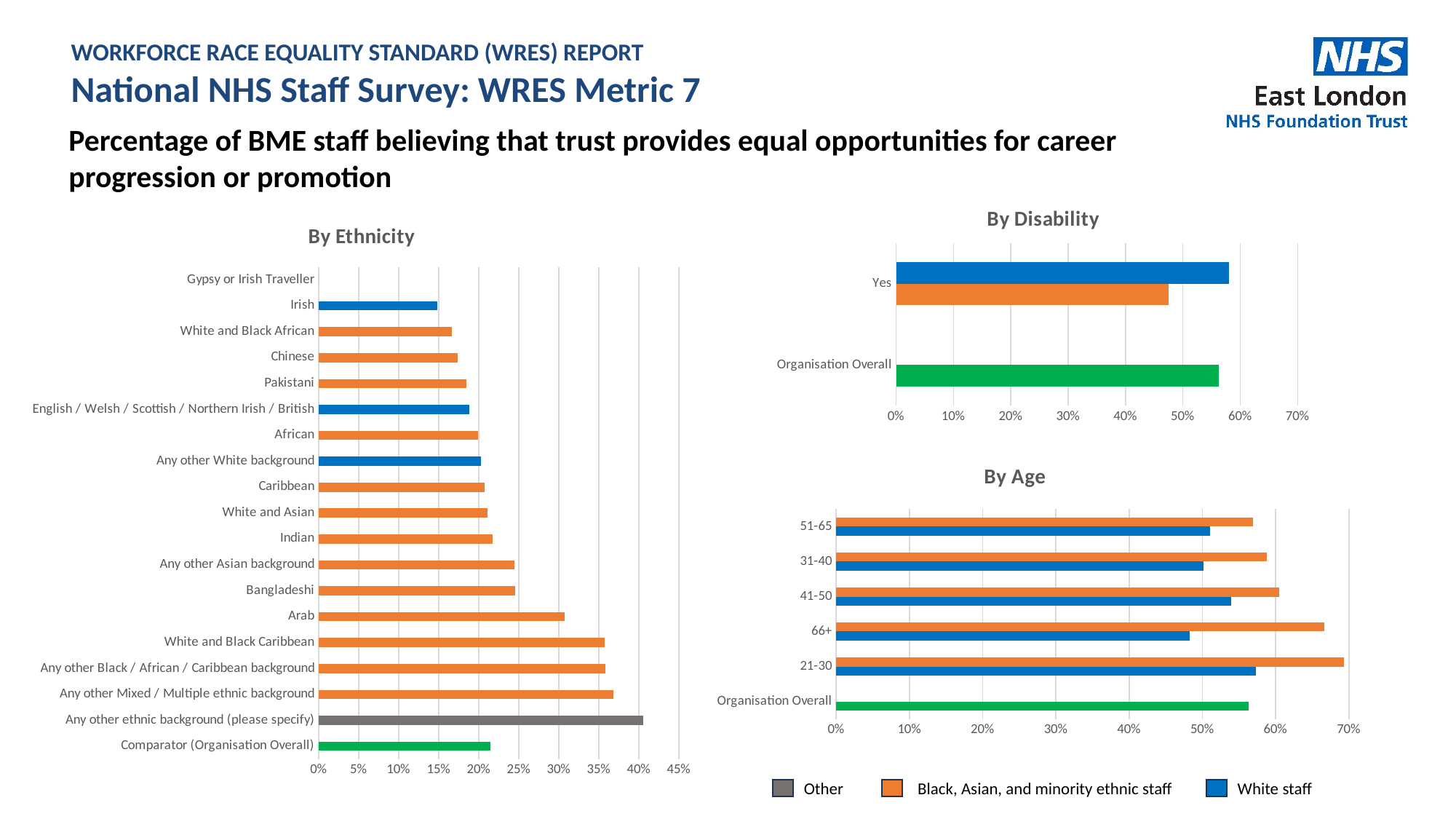
In the 'By Disability' chart, is the value for Black, Asian, and minority ethnic staff who answered Yes greater or less than 50%? less In the 'By Ethnicity' chart, is the value for Chinese greater or less than 20%? less What kind of chart is the 'By Ethnicity' chart? bar chart In the 'By Age' chart, which age group has the lowest value for White staff? 66+ In the 'By Ethnicity' chart, is the value for Any other Mixed / Multiple ethnic background greater or less than 35%? greater In the 'By Age' chart, which age group has the highest value for Black, Asian, and minority ethnic staff? 21-30 In the 'By Disability' chart, for the Yes category, which is larger, the value for White staff or for Black, Asian, and minority ethnic staff? White staff In the 'By Ethnicity' chart, which is larger, the value for Arab or the value for Indian? Arab In the 'By Ethnicity' chart, how many categories are listed on the vertical axis? 19 How many series does the legend at the bottom of the slide list? 3 In the 'By Ethnicity' chart, which category has the longest bar? Any other ethnic background (please specify)